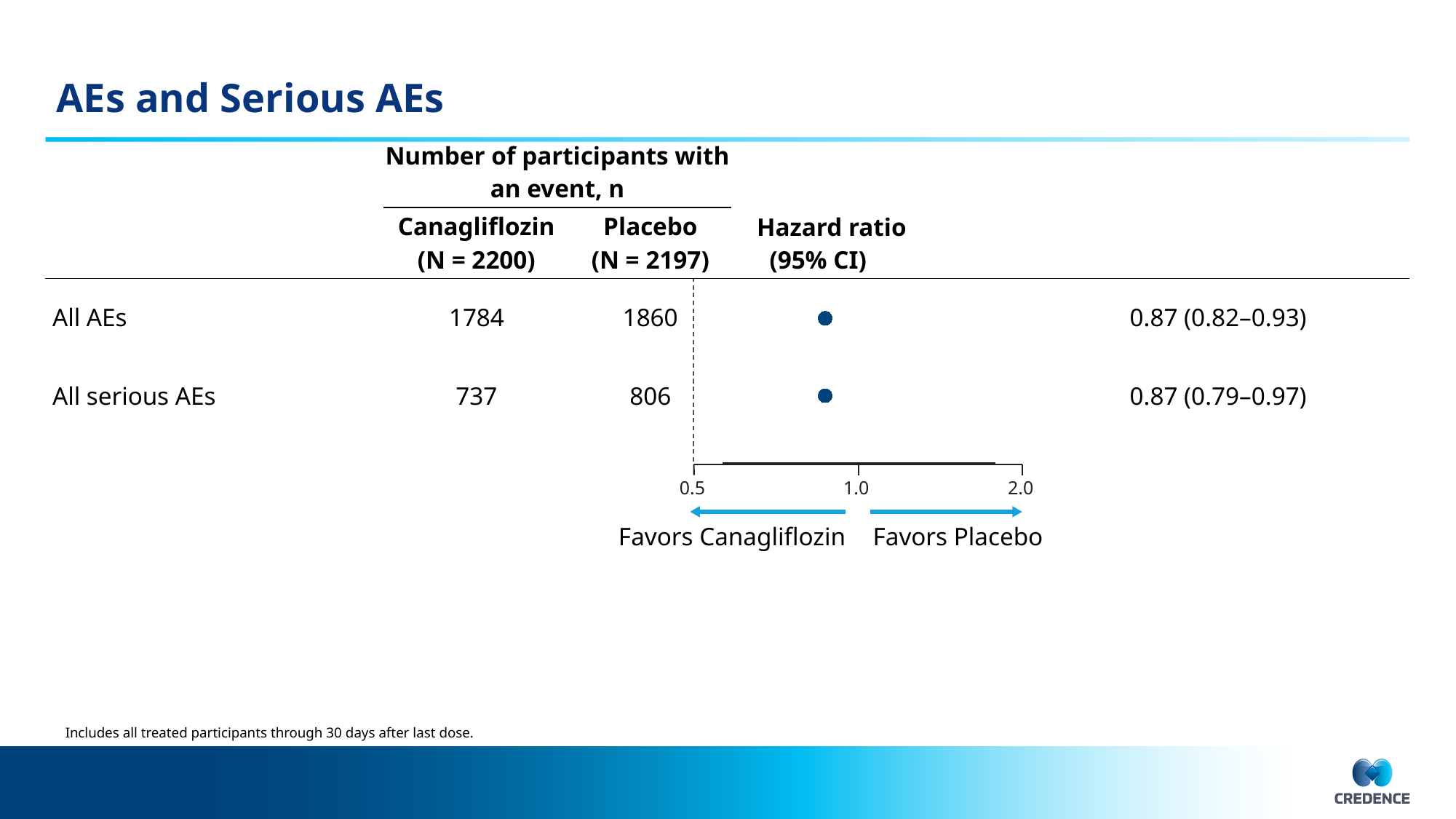
What is the hazard ratio (95% CI) for All serious AEs? 0.87 (0.79–0.97) What kind of chart is shown on the slide? Forest plot What is the difference between the Placebo and Canagliflozin counts for All AEs? 76 What are the tick values shown on the hazard ratio axis? 0.5, 1.0, 2.0 How many Placebo participants had an event in the All serious AEs row? 806 What is the hazard ratio (95% CI) for All AEs? 0.87 (0.82–0.93) For All AEs, which group had more participants with an event, Canagliflozin or Placebo? Placebo What is the difference between the Placebo and Canagliflozin counts for All serious AEs? 69 What does the left-pointing arrow below the axis indicate? Favors Canagliflozin Is the hazard ratio point estimate for All serious AEs greater or less than 1.0? less How many outcome rows are plotted in the forest plot? 2 How many Canagliflozin participants had an event in the All AEs row? 1784